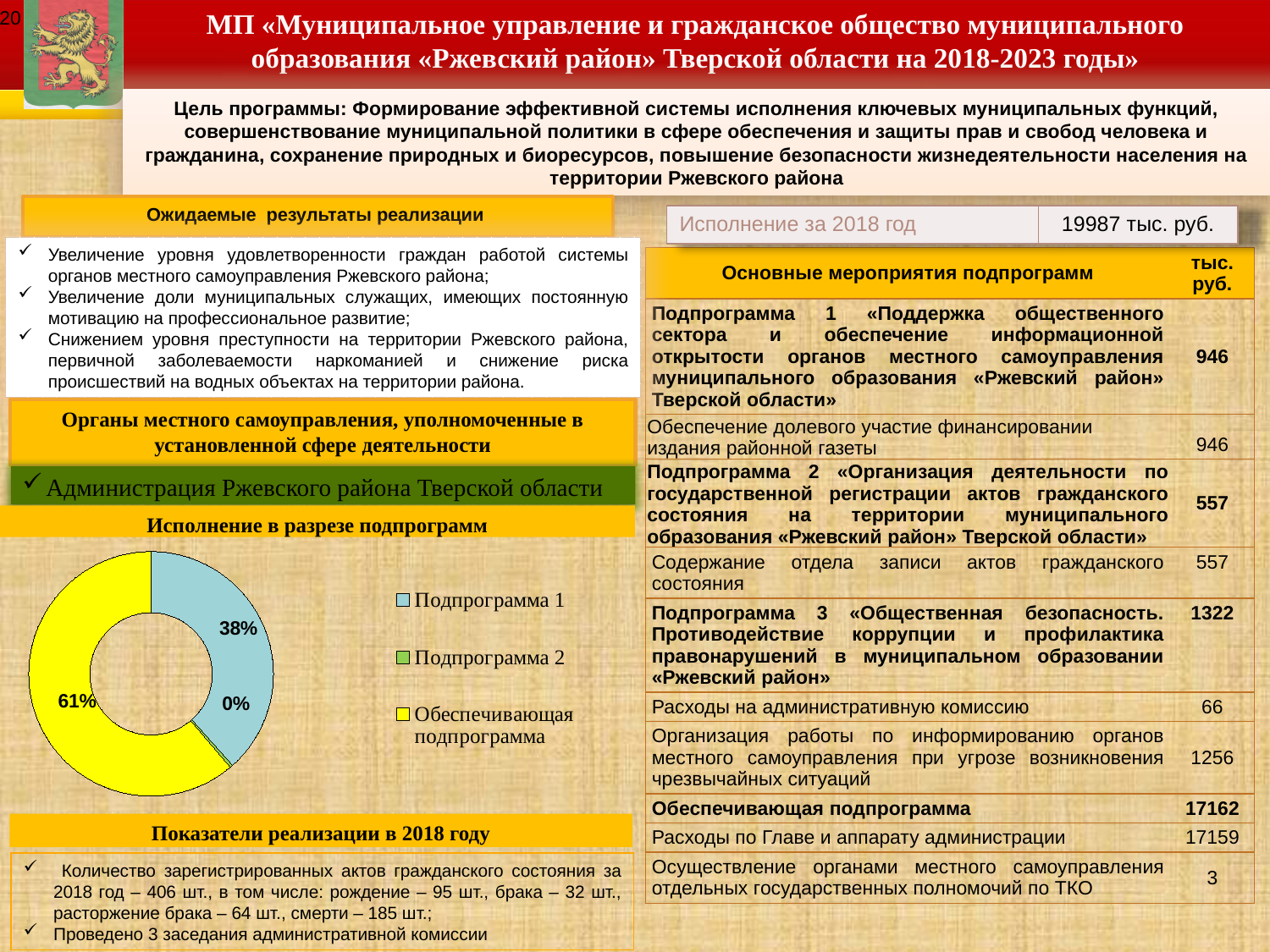
By how many percentage points does the share of «Обеспечивающая подпрограмма» exceed that of «Подпрограмма 1» in the doughnut chart? 23% What share of the doughnut chart does «Обеспечивающая подпрограмма» account for? 61% What colour represents «Обеспечивающая подпрограмма» in the doughnut chart? Yellow Which category has the smallest share in the doughnut chart? Подпрограмма 2 How many categories does the doughnut chart show? 3 Which category has the largest share in the doughnut chart? Обеспечивающая подпрограмма How many entries does the legend of the doughnut chart list? 3 What kind of chart is shown under the heading «Исполнение в разрезе подпрограмм»? Doughnut (pie) chart Which has the larger share in the doughnut chart, «Подпрограмма 1» or «Обеспечивающая подпрограмма»? Обеспечивающая подпрограмма What share of the doughnut chart does «Подпрограмма 1» account for? 38% What share of the doughnut chart does «Подпрограмма 2» account for? 0% What is the title above the doughnut chart? Исполнение в разрезе подпрограмм